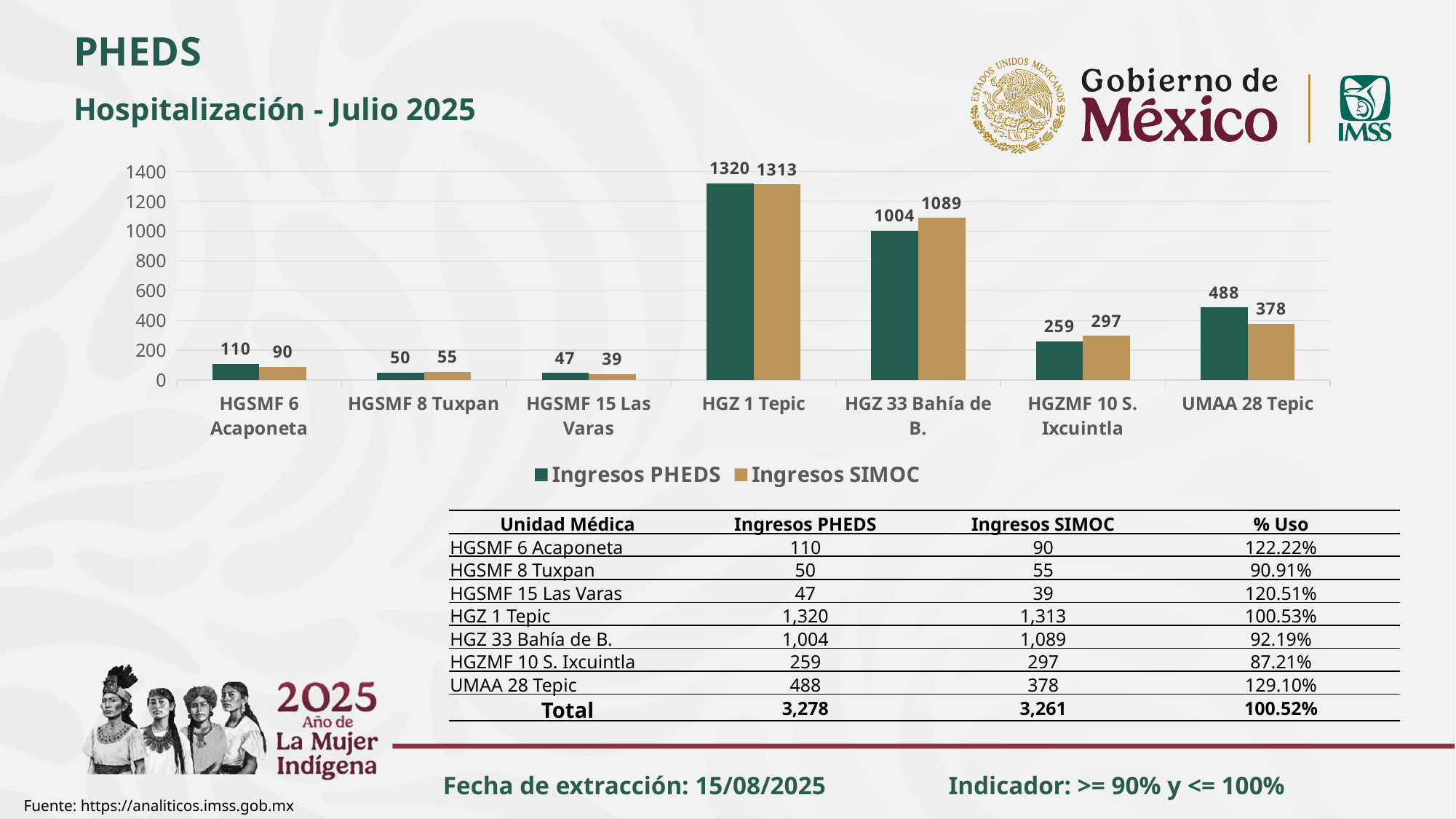
What is the difference between Ingresos SIMOC and Ingresos PHEDS for HGZ 33 Bahía de B.? 85 What is the Ingresos SIMOC value for UMAA 28 Tepic? 378 Is the Ingresos PHEDS value for HGZ 33 Bahía de B. greater or less than 800? greater What is the Ingresos SIMOC value for HGSMF 8 Tuxpan? 55 What kind of chart is shown on the slide? bar chart How many series does the chart legend list? 2 Which category has the lowest Ingresos SIMOC value? HGSMF 15 Las Varas How many categories are shown on the x axis of the chart? 7 For HGZMF 10 S. Ixcuintla, which is larger: Ingresos PHEDS or Ingresos SIMOC? Ingresos SIMOC Which category has the highest Ingresos PHEDS value? HGZ 1 Tepic What is the Ingresos PHEDS value for HGZ 1 Tepic? 1320 What is the difference between Ingresos PHEDS and Ingresos SIMOC for UMAA 28 Tepic? 110